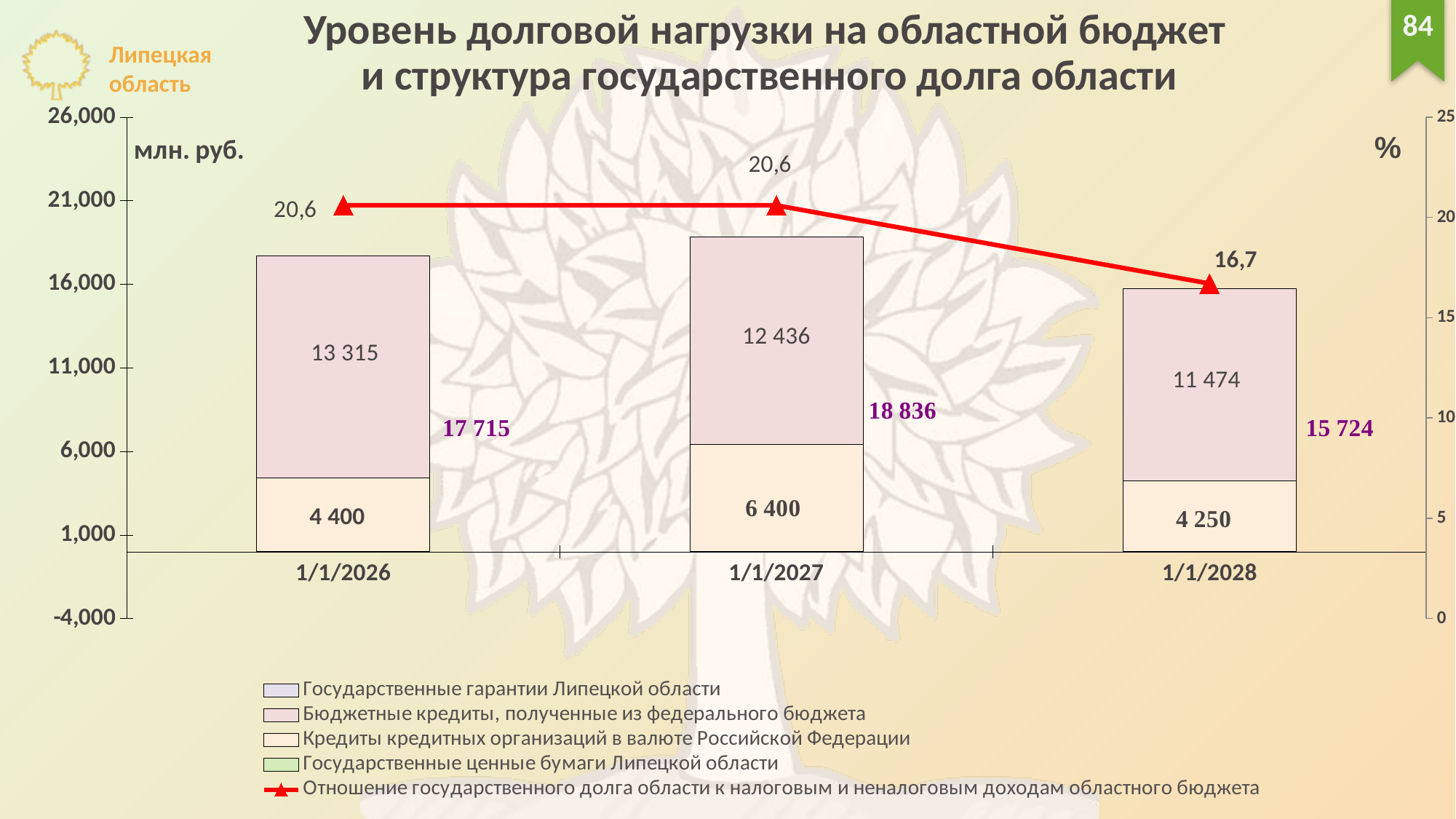
What kind of chart is this? Stacked bar chart with a line How many dates are shown on the x axis? 3 What is the value of the line Отношение государственного долга области к налоговым и неналоговым доходам областного бюджета on 1/1/2028? 16,7 Which is larger: the Кредиты кредитных организаций value on 1/1/2026 or on 1/1/2027? 1/1/2027 What is the total state debt shown above the bar for 1/1/2028? 15 724 What is the difference between the Бюджетные кредиты values on 1/1/2026 and 1/1/2028? 1 841 Does the Бюджетные кредиты, полученные из федерального бюджета value rise or fall from 1/1/2026 to 1/1/2028? Fall On which date is the total state debt highest? 1/1/2027 On which date is the value of Кредиты кредитных организаций в валюте Российской Федерации lowest? 1/1/2028 How many entries does the legend list? 5 What is the value of Бюджетные кредиты, полученные из федерального бюджета on 1/1/2026? 13 315 What is the value of Кредиты кредитных организаций в валюте Российской Федерации on 1/1/2027? 6 400